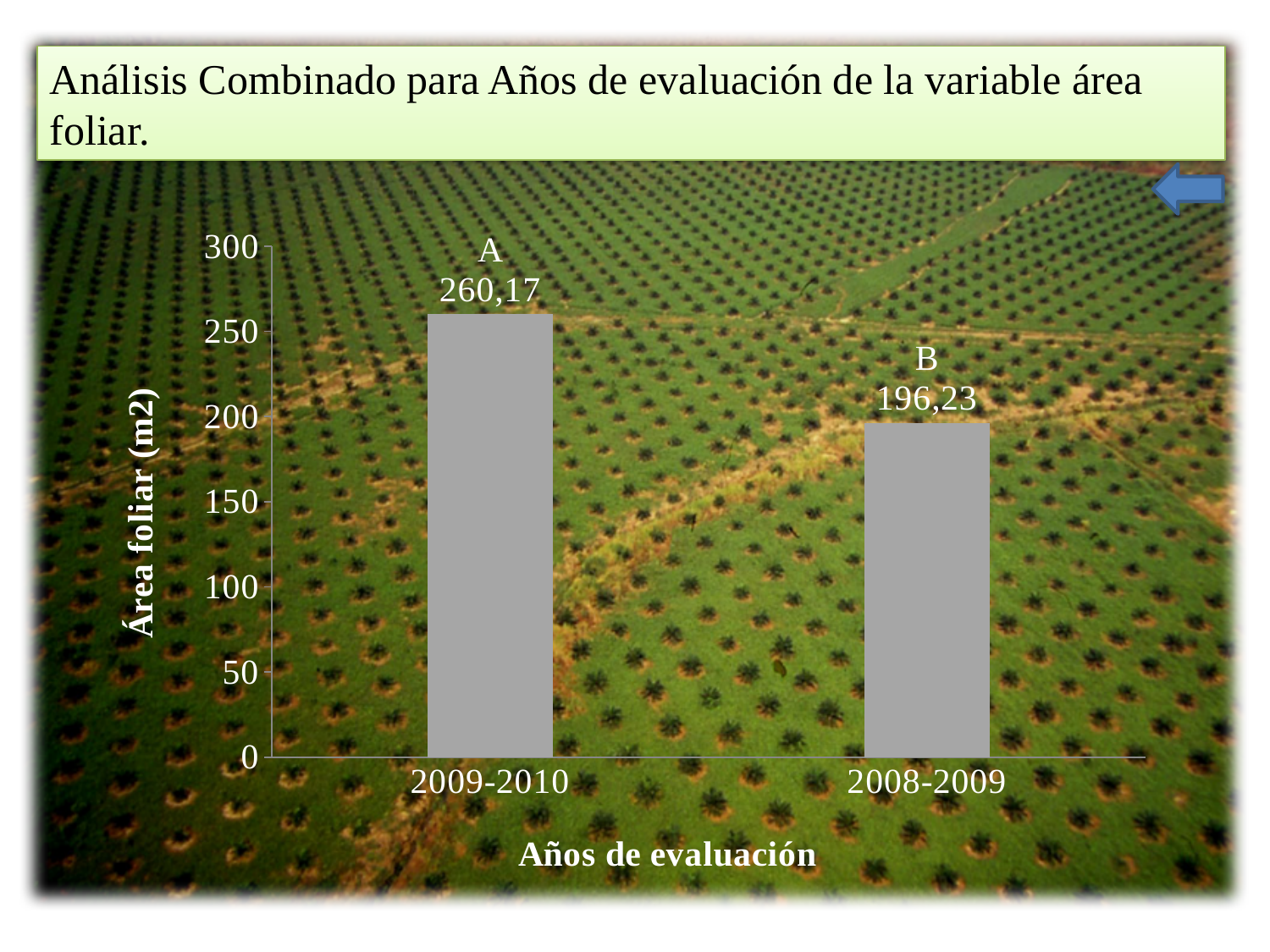
What is the área foliar value for 2008-2009? 196,23 What letter is shown above the bar for 2008-2009? B What is the área foliar value for 2009-2010? 260,17 Which evaluation year has the highest área foliar? 2009-2010 What is the label of the y axis? Área foliar (m2) Is the value for 2009-2010 greater or less than 250? greater What is the difference between the área foliar values for 2009-2010 and 2008-2009? 63,94 How many evaluation-year categories are shown on the chart? 2 Which evaluation year has the lowest área foliar? 2008-2009 Which is larger, the área foliar for 2009-2010 or for 2008-2009? 2009-2010 Is the value for 2008-2009 greater or less than 200? less What kind of chart is shown on the slide? bar chart